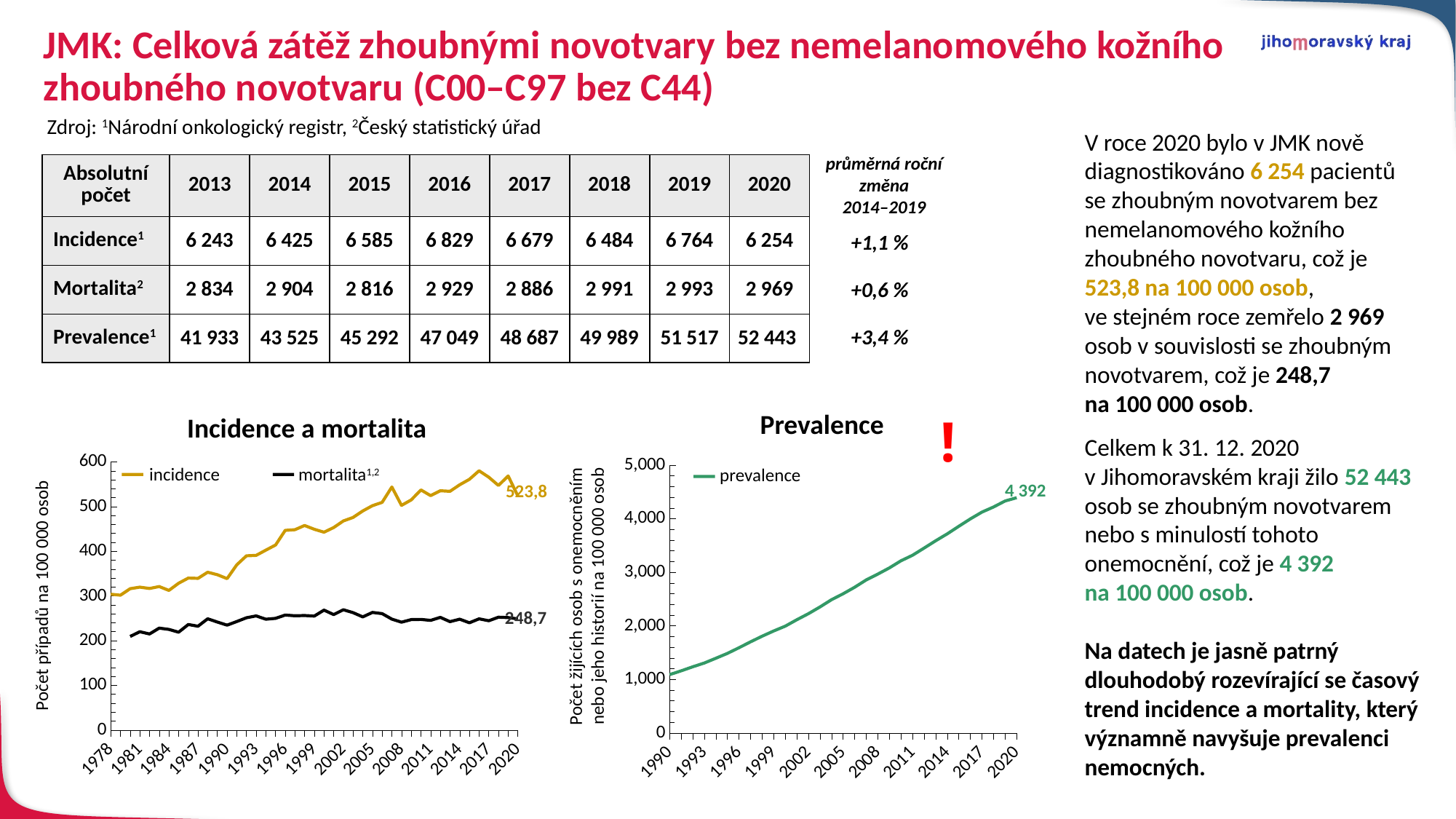
In the 'Prevalence' chart, is the value for 1990 greater or less than 2,000? less In the 'Incidence a mortalita' chart, what is the incidence value labelled for 2020? 523,8 In the 'Prevalence' chart, how many series does the legend list? 1 In the 'Incidence a mortalita' chart, which series has the higher value in 2020, incidence or mortalita? incidence In the 'Incidence a mortalita' chart, how many series does the legend list? 2 In the 'Incidence a mortalita' chart, what is the difference between the 2020 incidence and mortalita values? 275,1 In the 'Incidence a mortalita' chart, what kind of chart is it? line chart In the 'Incidence a mortalita' chart, what is the mortalita value labelled for 2020? 248,7 In the 'Incidence a mortalita' chart, does the incidence line generally rise or fall from 1978 to 2020? rise In the 'Prevalence' chart, does the prevalence line rise or fall from 1990 to 2020? rise In the 'Prevalence' chart, what is the value labelled for 2020? 4 392 In the 'Incidence a mortalita' chart, is the incidence value for 1978 greater or less than 400? less